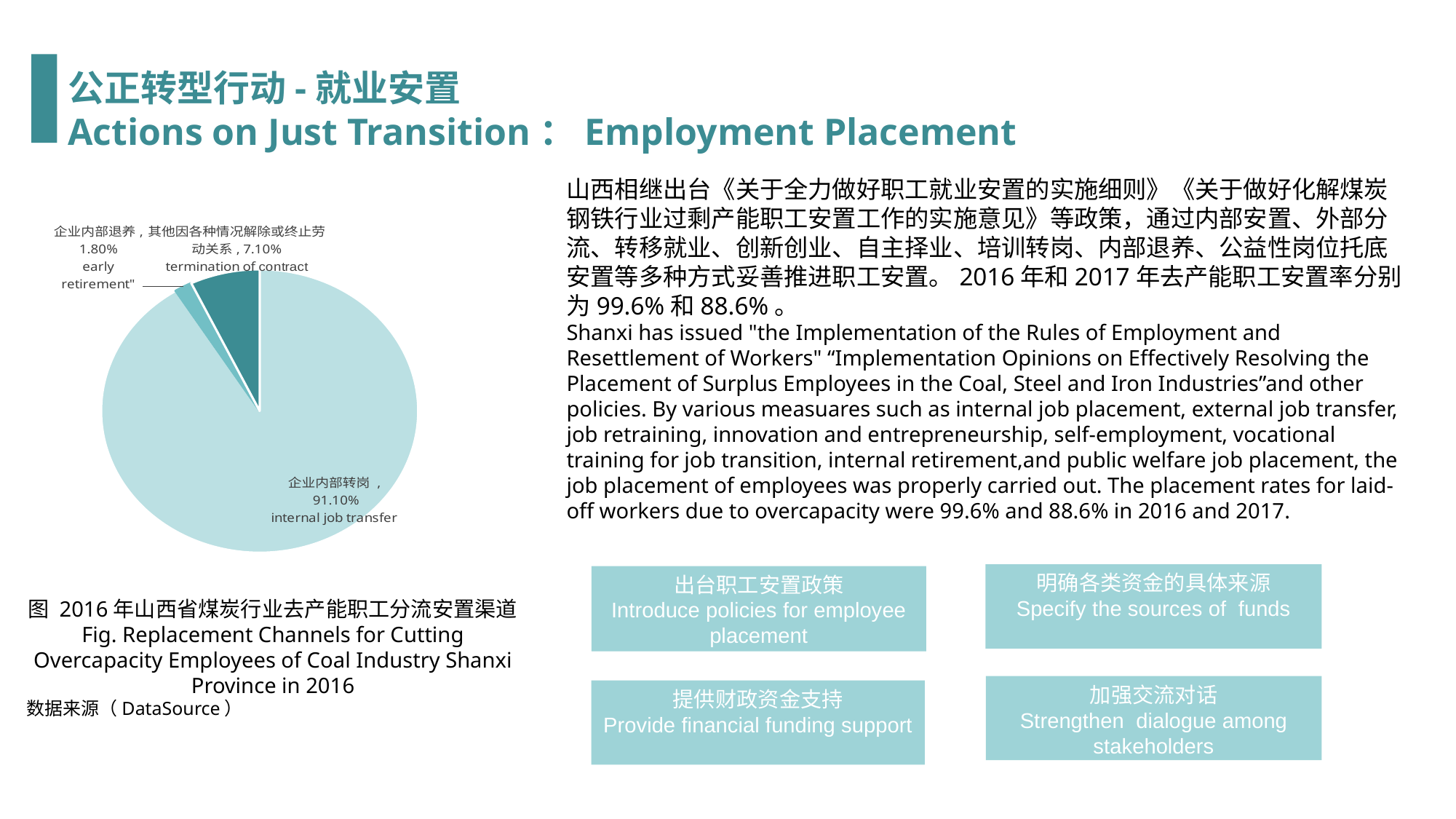
Which category has the smallest slice of the pie? Early retirement What is the value shown for early retirement? 1.80% What is the difference between the shares for termination of contract and early retirement? 5.30% Which province's coal industry does the pie chart describe? Shanxi Province What is the difference between the shares for internal job transfer and termination of contract? 84.00% What year does the pie chart's caption say the data is for? 2016 What is the value shown for termination of contract? 7.10% Which category has the largest slice of the pie? Internal job transfer What kind of chart is shown on the slide? Pie chart What share of the pie does internal job transfer account for? 91.10% How many slices does the pie chart have? 3 Which is larger, the share for termination of contract or the share for early retirement? Termination of contract